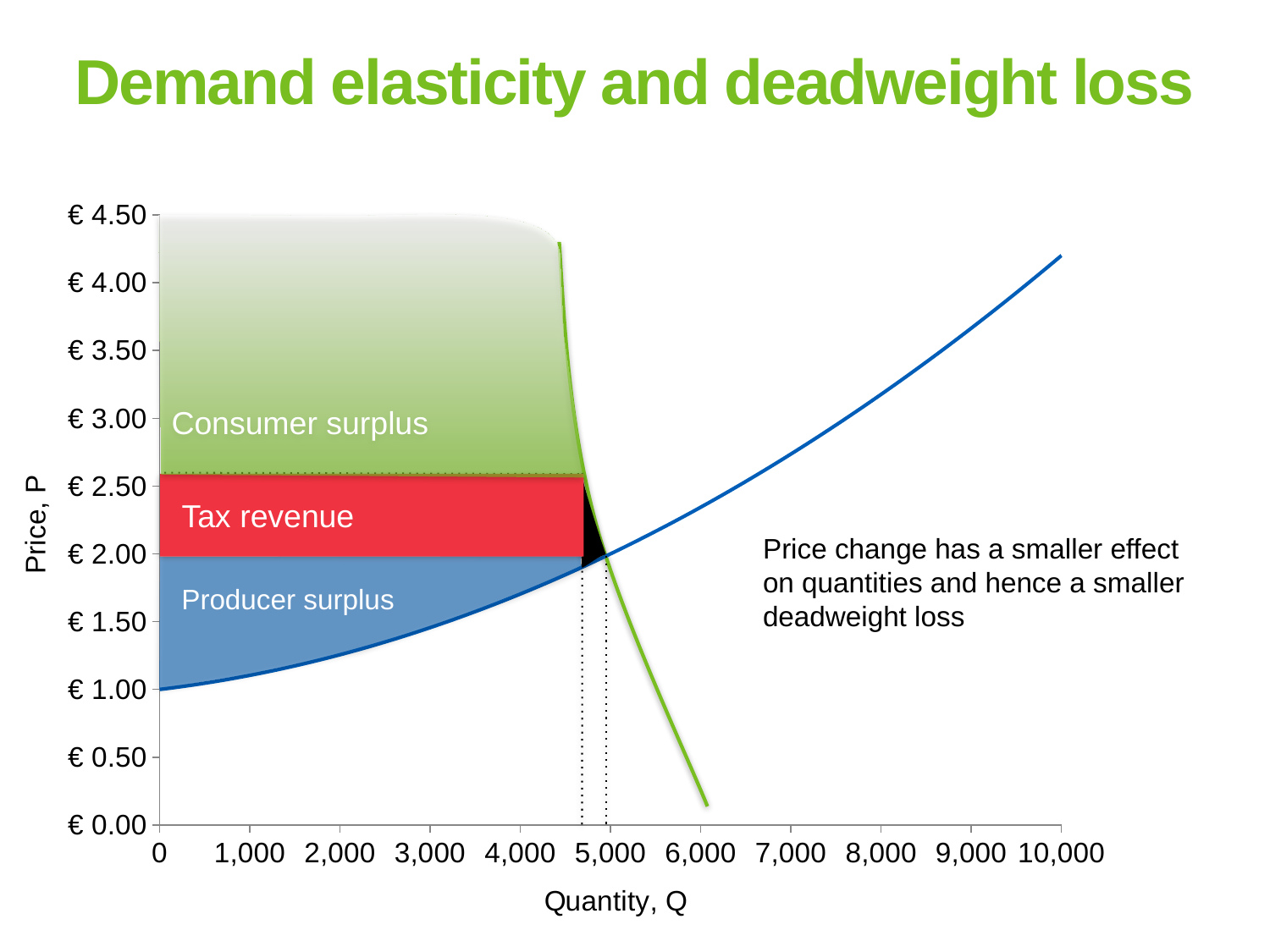
How many tick labels are shown on the horizontal axis of the chart? 11 What kind of chart is shown on the slide? line chart Is the price on the blue curve at a quantity of 2,000 greater or less than € 1.50? less What is the highest price value shown on the vertical axis? € 4.50 What label is shown on the vertical axis of the chart? Price, P Is the price on the green curve at a quantity of 6,000 greater or less than € 0.50? less Does the blue curve rise or fall as quantity increases along the x axis? rise Is the price on the blue curve at a quantity of 10,000 greater or less than € 4.00? greater What is the price on the blue curve at a quantity of 0? € 1.00 Does the green curve rise or fall as quantity increases along the x axis? fall What is the title of the chart on the slide? Demand elasticity and deadweight loss